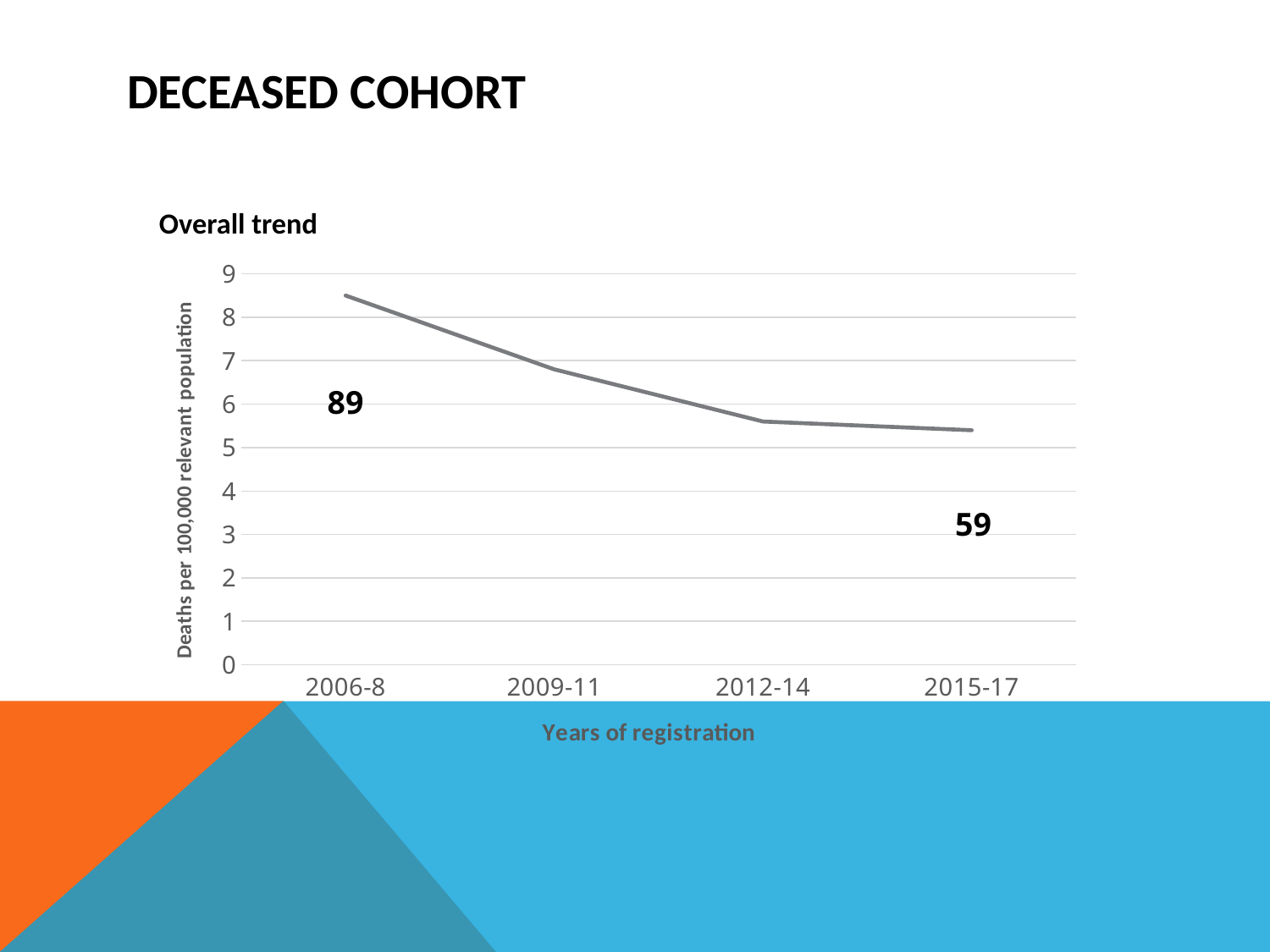
Is the value for 2012-14 greater or less than 6? less Is the value for 2009-11 greater or less than 6? greater Is the value for 2015-17 greater or less than 5? greater What is the label on the vertical axis of the chart? Deaths per 100,000 relevant population What kind of chart is shown on the slide? line chart What is the title of the chart? Overall trend Which has the larger value, 2009-11 or 2015-17? 2009-11 Do the values rise or fall from 2006-8 to 2015-17? fall How many year-of-registration periods are plotted on the x axis? 4 Which has the larger value, 2006-8 or 2012-14? 2006-8 Which period of registration has the highest value on the chart? 2006-8